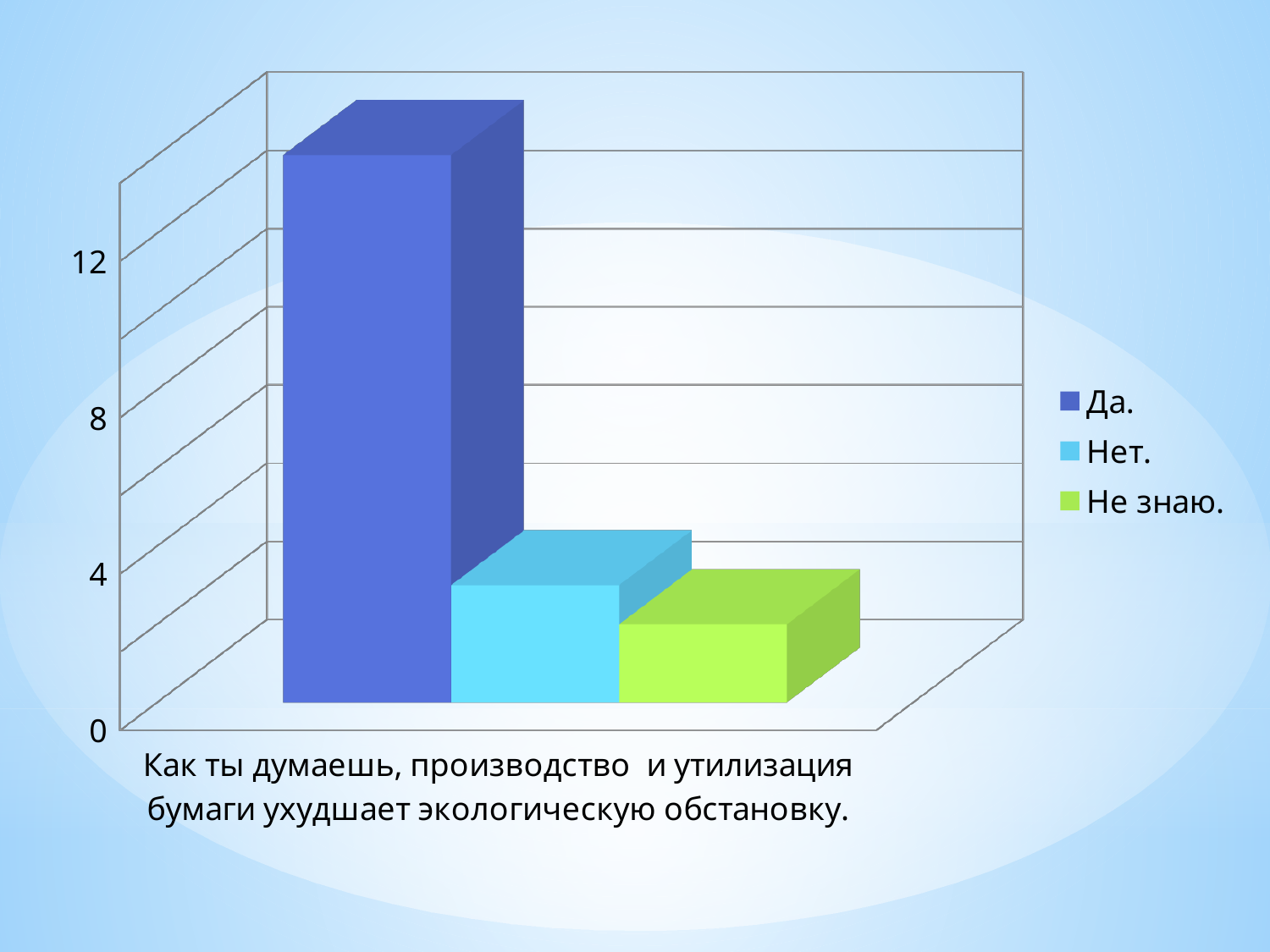
How many series does the legend list? 3 Which is larger, the value for Да. or the value for Нет.? Да. Is the value for Не знаю. greater or less than 4? less Which is larger, the value for Нет. or the value for Не знаю.? Нет. What are the three entries listed in the legend? Да., Нет., Не знаю. Which answer option has the lowest bar? Не знаю. Which answer option has the highest bar? Да. How many bars are plotted in the chart? 3 Is the value for Нет. greater or less than 8? less Is the value for Да. greater or less than 12? greater What colour is the bar for Да.? blue What kind of chart is shown on the slide? bar chart